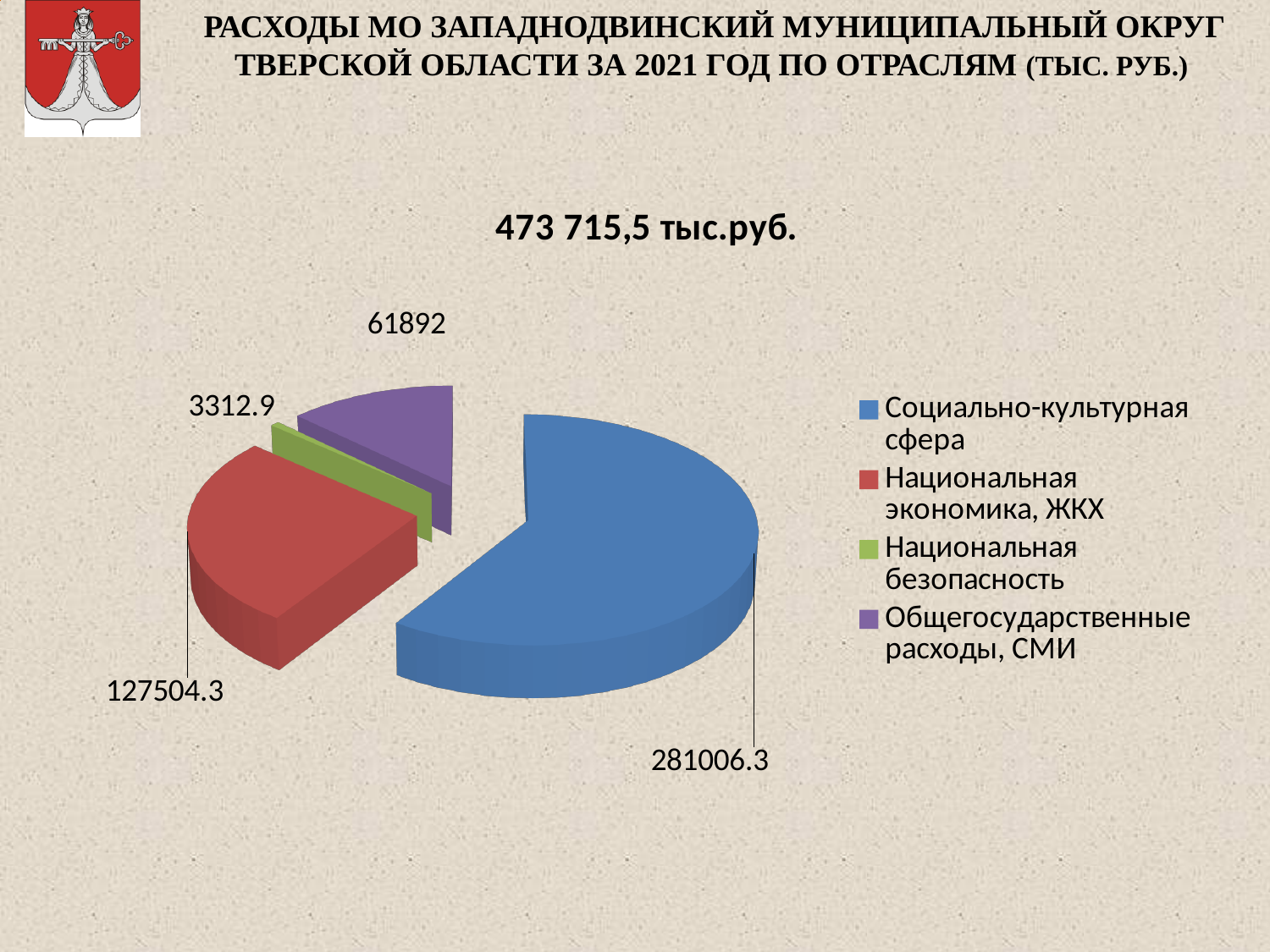
Which category has the smallest slice of the pie? Национальная безопасность How many categories does the pie chart show? 4 What is the value for Национальная экономика, ЖКХ? 127504.3 What kind of chart is shown on the slide? Pie chart What is the difference between the values for Общегосударственные расходы, СМИ and Национальная безопасность? 58579.1 What is the value for Общегосударственные расходы, СМИ? 61892 Which category has the largest slice of the pie? Социально-культурная сфера What is the difference between the values for Социально-культурная сфера and Национальная экономика, ЖКХ? 153502 What total amount is printed above the pie chart? 473 715,5 тыс.руб. What is the value for Социально-культурная сфера? 281006.3 Which is larger: Национальная экономика, ЖКХ or Общегосударственные расходы, СМИ? Национальная экономика, ЖКХ What is the value for Национальная безопасность? 3312.9